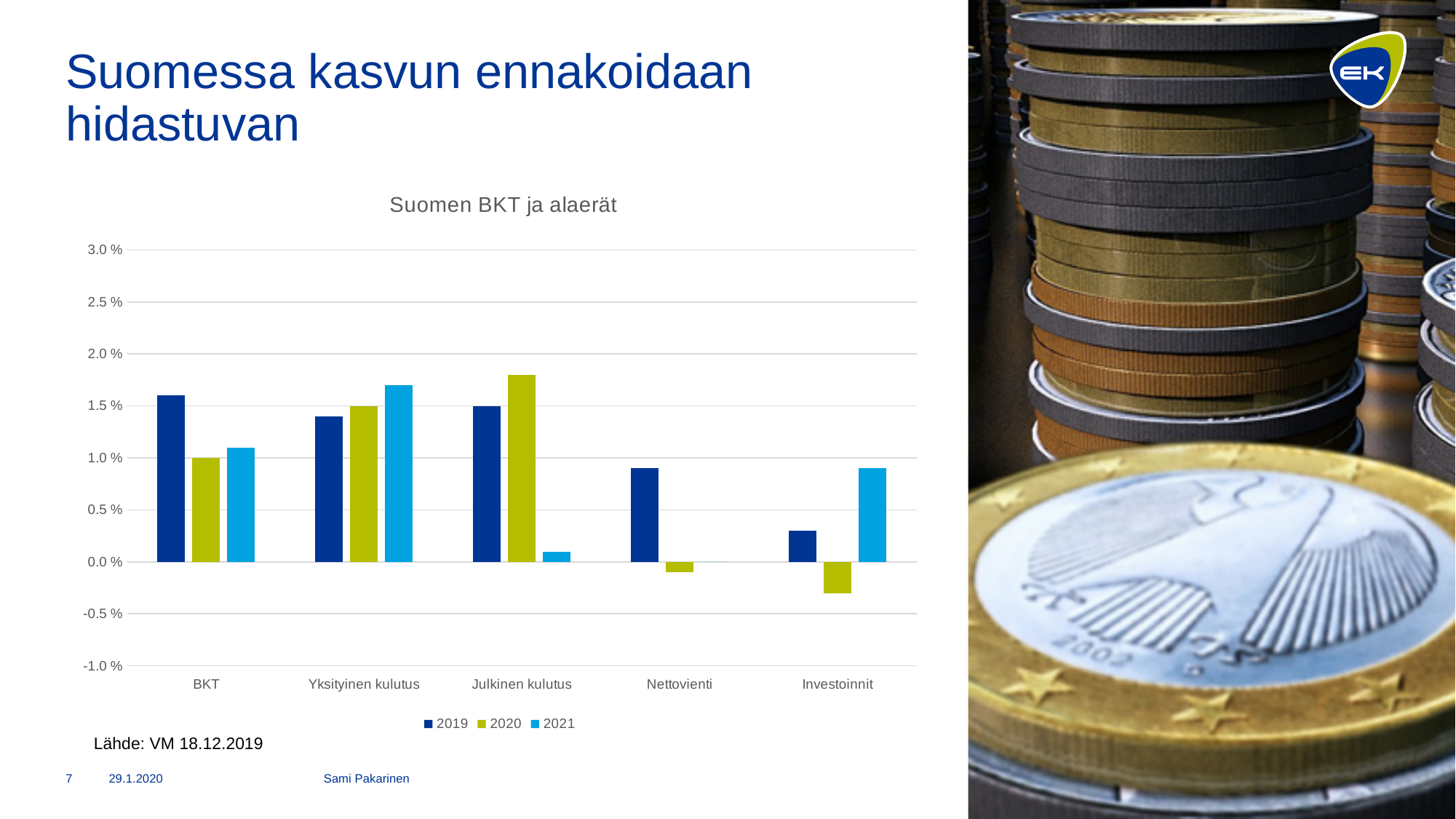
Which category has the highest value for 2020? Julkinen kulutus How many series does the legend list? 3 Is the value for Investoinnit in 2020 greater or less than 0.0 %? less Which category has the highest value for 2021? Yksityinen kulutus Which category has the lowest value for 2020? Investoinnit What is the value for BKT in 2020? 1.0 % What is the title of the chart? Suomen BKT ja alaerät Which is larger for 2019: Nettovienti or Investoinnit? Nettovienti What is the value for Yksityinen kulutus in 2020? 1.5 % Is the value for Julkinen kulutus in 2020 greater or less than 1.5 %? greater How many categories are shown on the x axis? 5 What kind of chart is shown on the slide? bar chart